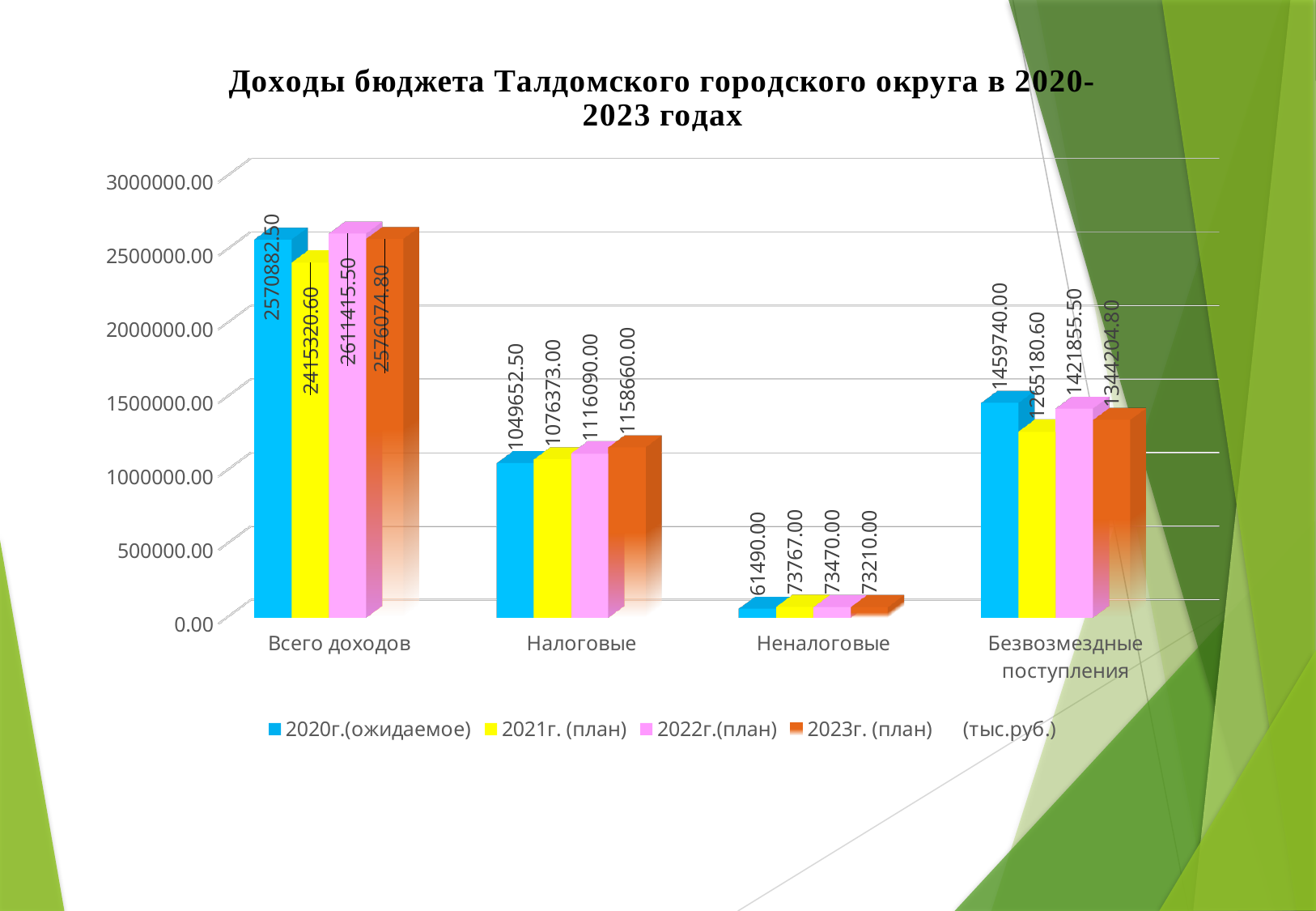
What is the value for Безвозмездные поступления in the 2023г. (план) series? 1344204.80 What is the value for Всего доходов in the 2020г.(ожидаемое) series? 2570882.50 Is the 2020г.(ожидаемое) value for Налоговые greater or less than 1000000.00? greater How many data series does the legend list? 4 What is the value for Неналоговые in the 2021г. (план) series? 73767.00 Which is larger for Безвозмездные поступления: the 2022г.(план) value or the 2023г. (план) value? 2022г.(план) Which series has the highest value for Всего доходов? 2022г.(план) What kind of chart is shown on the slide? bar chart What is the difference between the 2023г. (план) and 2020г.(ожидаемое) values for Налоговые? 109007.50 Do the Налоговые values rise or fall from the 2020г.(ожидаемое) series to the 2023г. (план) series? rise Which series has the lowest value for Неналоговые? 2020г.(ожидаемое) How many categories are shown on the x axis? 4